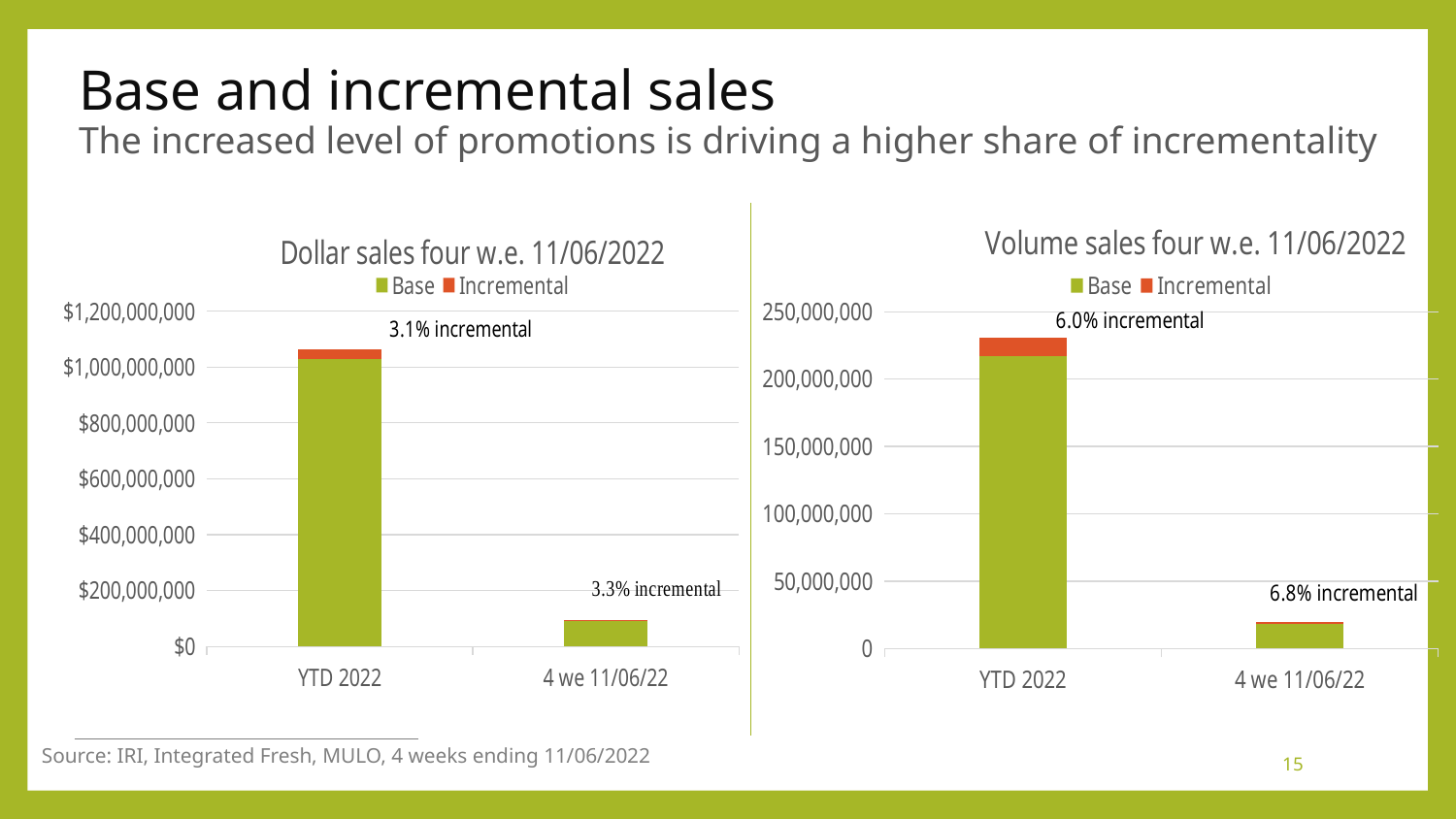
In the 'Dollar sales four w.e. 11/06/2022' chart, is the total bar for 4 we 11/06/22 greater or less than $200,000,000? less In the 'Dollar sales four w.e. 11/06/2022' chart, what incremental percentage is labelled for YTD 2022? 3.1% incremental In the 'Volume sales four w.e. 11/06/2022' chart, which category has the taller bar, YTD 2022 or 4 we 11/06/22? YTD 2022 In the 'Volume sales four w.e. 11/06/2022' chart, is the total bar for YTD 2022 greater or less than 200,000,000? greater How many series does the legend of the 'Volume sales four w.e. 11/06/2022' chart list? 2 In the 'Volume sales four w.e. 11/06/2022' chart, what incremental percentage is labelled for 4 we 11/06/22? 6.8% incremental In the 'Dollar sales four w.e. 11/06/2022' chart, which colour represents the Incremental series? Orange In the 'Volume sales four w.e. 11/06/2022' chart, what incremental percentage is labelled for YTD 2022? 6.0% incremental In the 'Dollar sales four w.e. 11/06/2022' chart, is the total bar for YTD 2022 greater or less than $1,000,000,000? greater What kind of chart is the 'Dollar sales four w.e. 11/06/2022' chart? Stacked bar chart In the 'Dollar sales four w.e. 11/06/2022' chart, what incremental percentage is labelled for 4 we 11/06/22? 3.3% incremental How many categories are shown on the x axis of the 'Dollar sales four w.e. 11/06/2022' chart? 2